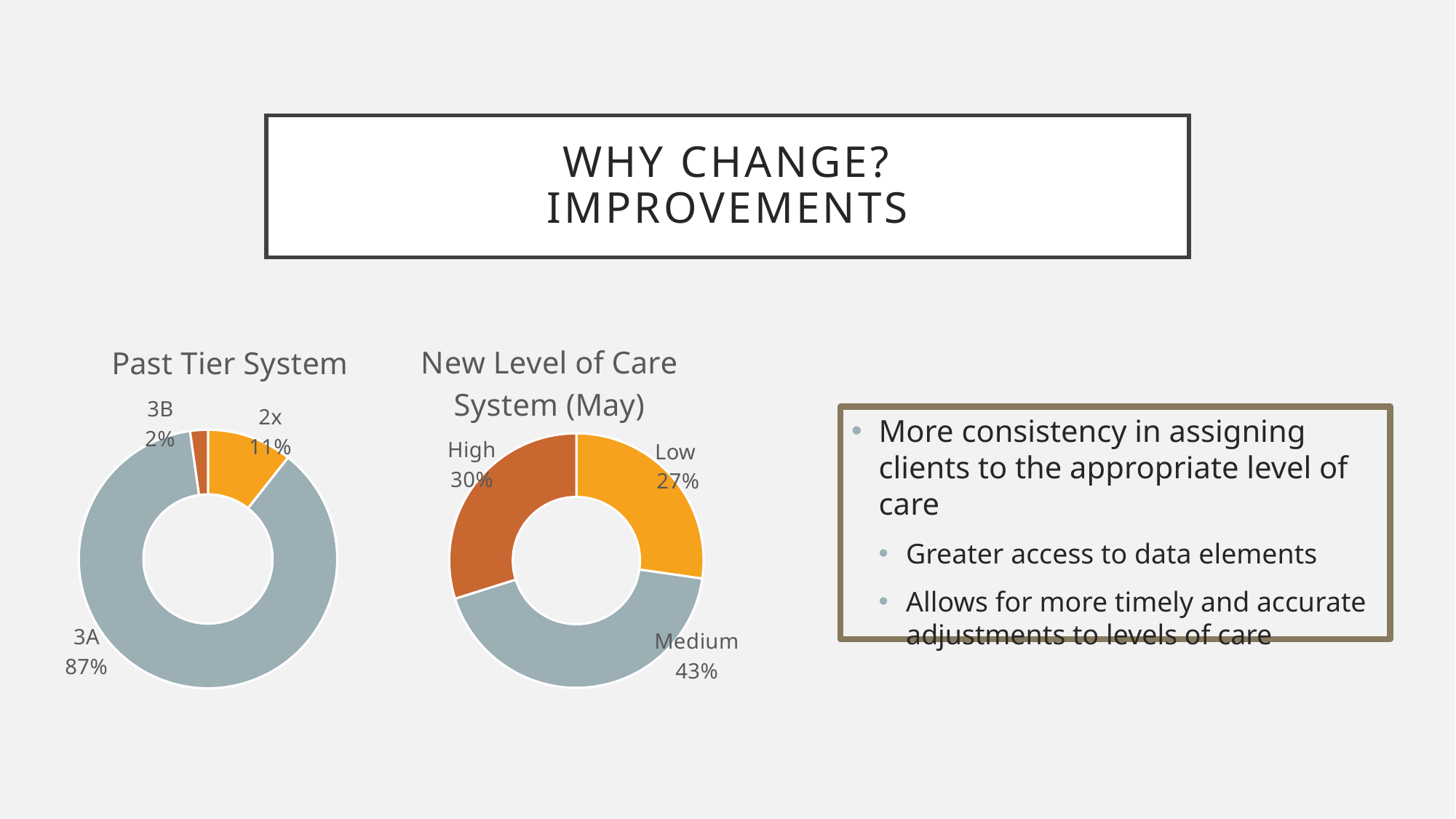
In the Past Tier System chart, which category has the largest share? 3A In the New Level of Care System (May) chart, what percentage is shown for High? 30% How many categories does the New Level of Care System (May) chart show? 3 In the Past Tier System chart, what percentage is shown for 3B? 2% In the Past Tier System chart, what percentage is shown for 2x? 11% In the New Level of Care System (May) chart, which category has the lowest share? Low What kind of chart is the Past Tier System chart? Doughnut chart In the New Level of Care System (May) chart, what percentage is shown for Medium? 43% In the New Level of Care System (May) chart, what is the difference between the Medium and Low percentages? 16% In the Past Tier System chart, what percentage is shown for 3A? 87% What is the title of the chart on the left of the slide? Past Tier System In the Past Tier System chart, which is larger, 2x or 3B? 2x